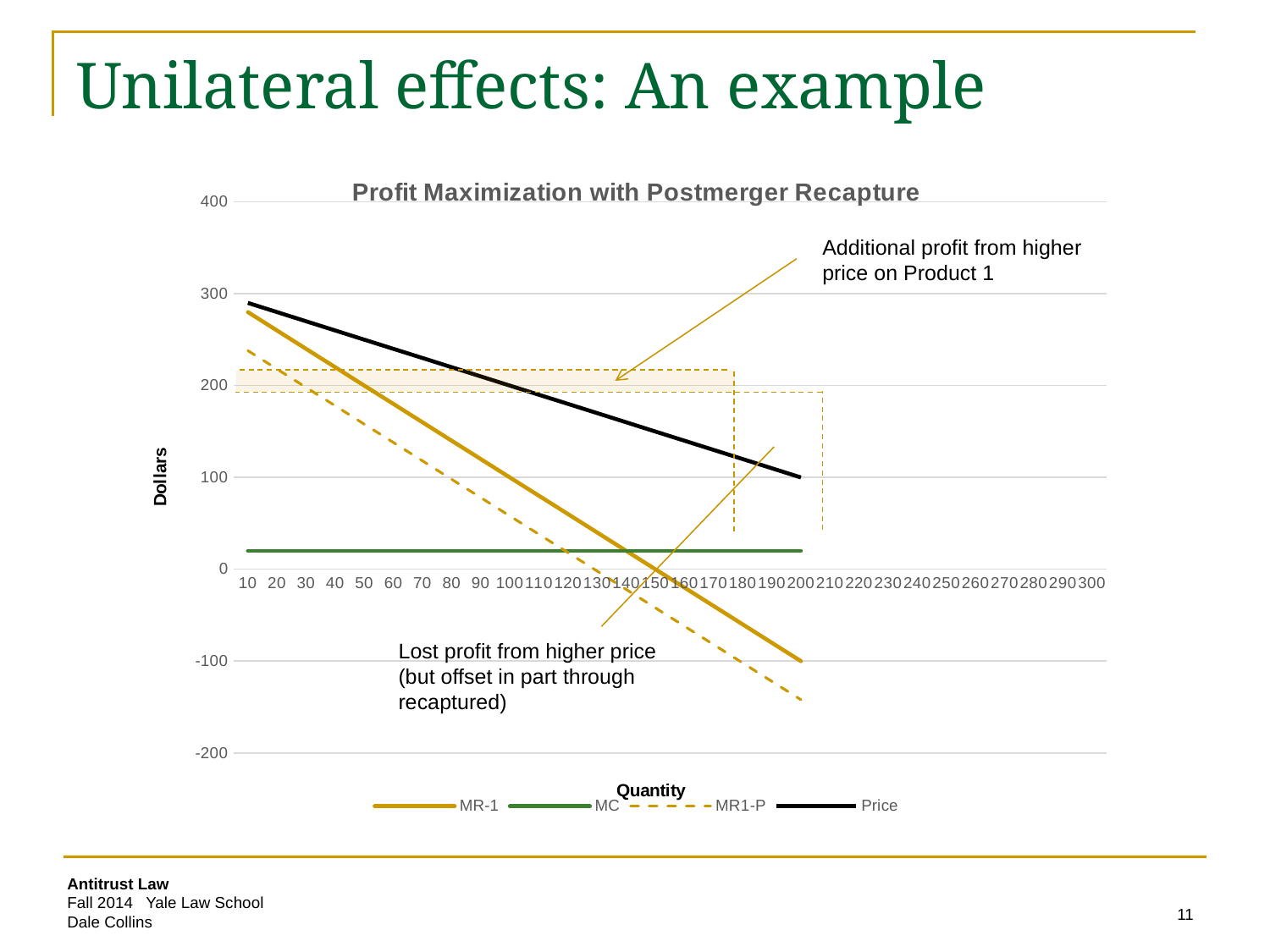
Is the value of the Price line at quantity 10 greater or less than 200? greater Which series stays flat across all quantities? MC How many series does the legend list? 4 What is the title of the chart? Profit Maximization with Postmerger Recapture What is the label on the x axis of the chart? Quantity Does the MR-1 line rise or fall as quantity increases? fall At quantity 50, which is larger, the MR-1 line or the MR1-P line? MR-1 At quantity 100, which is larger, the Price line or the MR-1 line? Price Is the value of the MR-1 line at quantity 200 greater or less than 0? less Is the value of the MC line greater or less than 100? less Does the Price line rise or fall as quantity increases? fall What kind of chart is shown on the slide? line chart